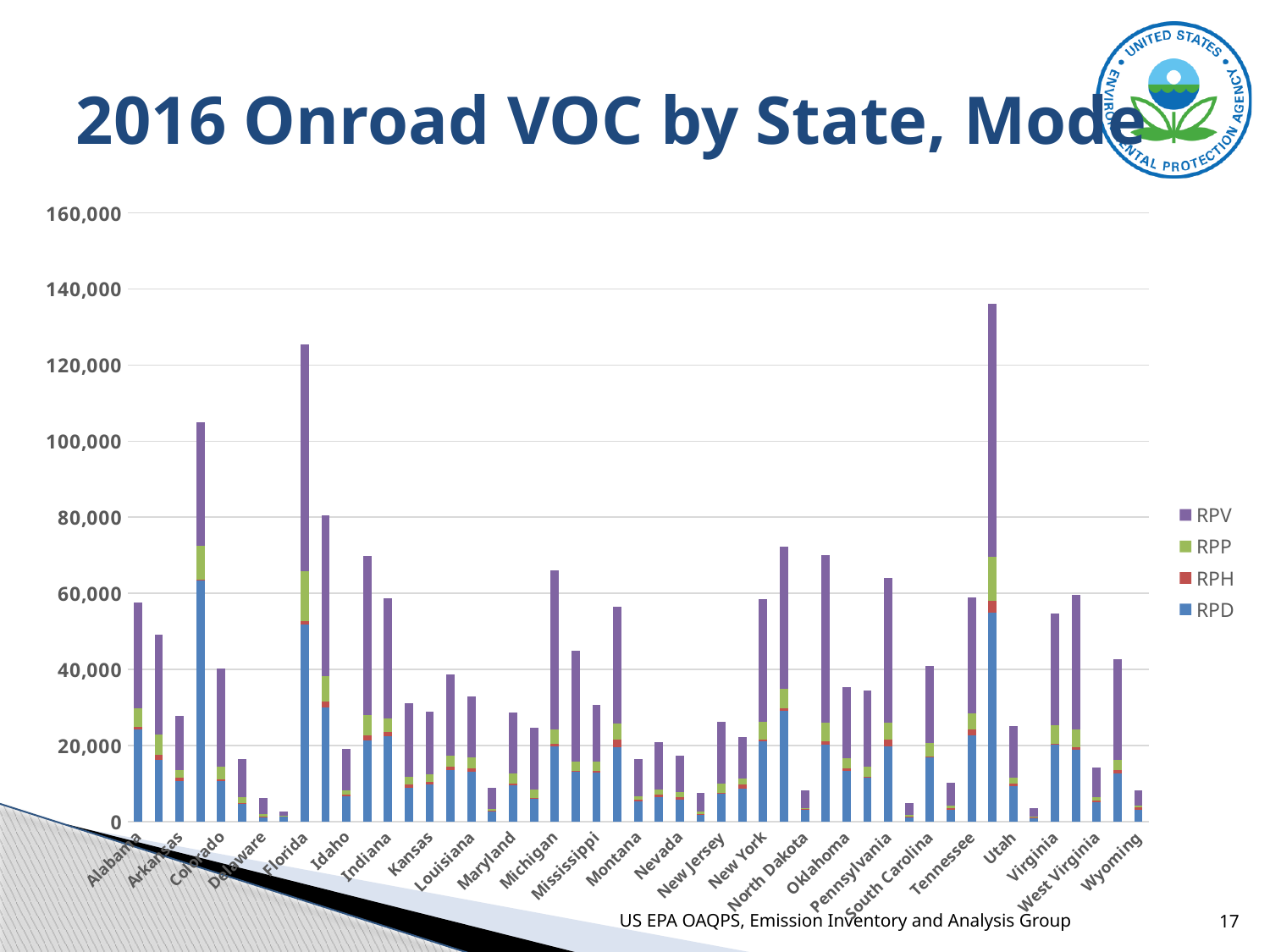
Is the total value for Michigan greater or less than 60,000? greater Is the total value for Florida greater or less than 120,000? greater What is the title of the chart? 2016 Onroad VOC by State, Mode Is the total value for Wyoming greater or less than 20,000? less Which state has the larger total, Florida or Colorado? Florida How many series does the legend list? 4 Which state has the larger total, Michigan or Montana? Michigan What type of chart is shown on the slide? Stacked bar chart What are the series names listed in the legend? RPV, RPP, RPH, RPD